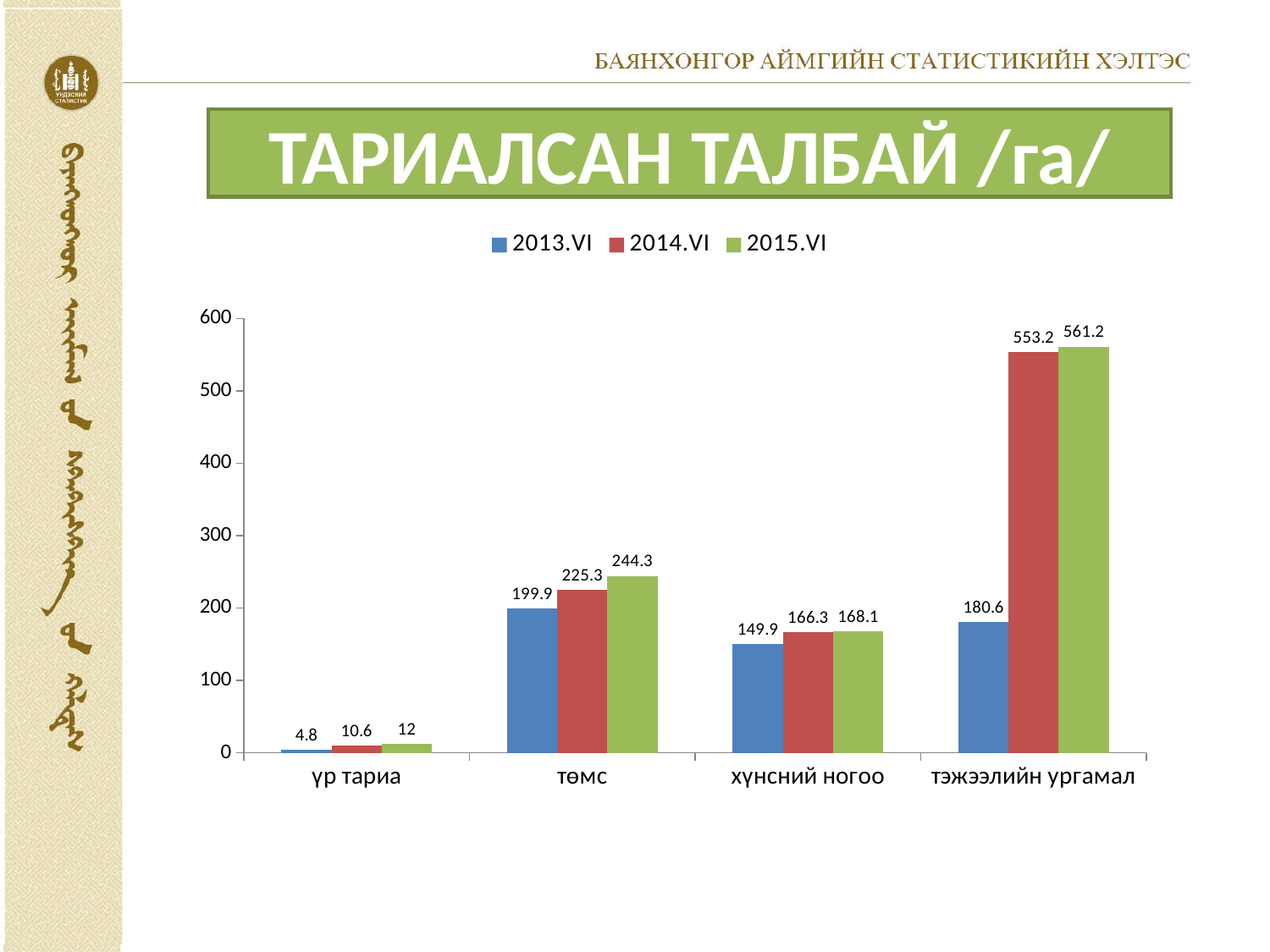
Which category has the lowest value in the 2013.VI series? үр тариа Which is larger: the 2013.VI value for төмс or the 2013.VI value for тэжээлийн ургамал? төмс How many categories are shown on the x axis? 4 How many series does the legend list? 3 What is the value for хүнсний ногоо in the 2014.VI series? 166.3 What is the value for үр тариа in the 2015.VI series? 12 What is the value for төмс in the 2015.VI series? 244.3 What is the difference between the 2014.VI and 2013.VI values for төмс? 25.4 What is the value for тэжээлийн ургамал in the 2013.VI series? 180.6 Which category has the highest value in the 2015.VI series? тэжээлийн ургамал What kind of chart is shown on the slide? bar chart What is the difference between the 2015.VI and 2014.VI values for тэжээлийн ургамал? 8